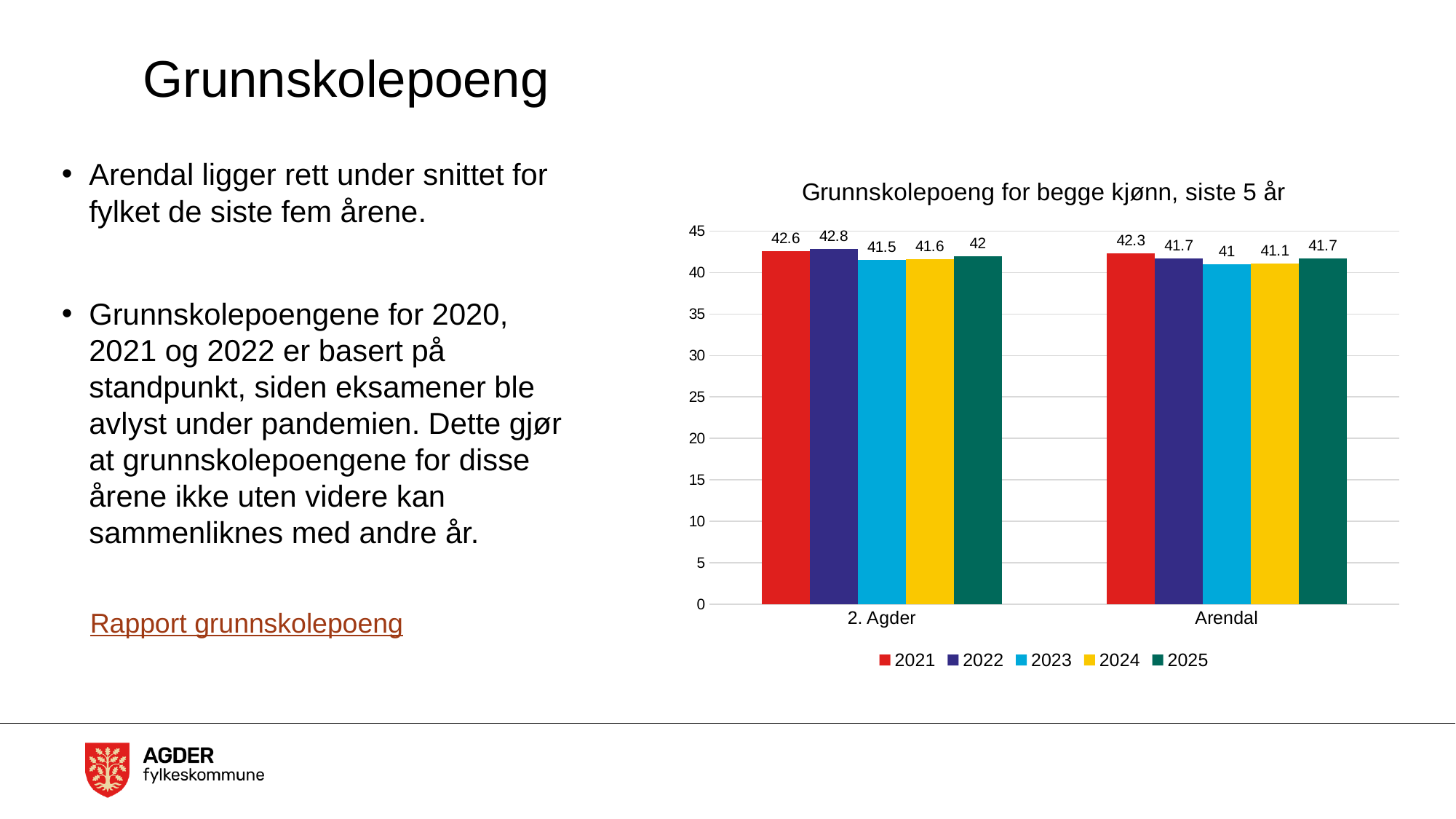
What is the difference between the 2021 values for 2. Agder and Arendal? 0.3 What is the value for Arendal in 2025? 41.7 What is the value for Arendal in 2023? 41 What is the title of the chart? Grunnskolepoeng for begge kjønn, siste 5 år What is the value for 2. Agder in 2022? 42.8 Which year has the lowest value for Arendal? 2023 Which is larger, the 2024 value for 2. Agder or the 2024 value for Arendal? 2. Agder Which year has the highest value for 2. Agder? 2022 How many series does the legend list? 5 What kind of chart is shown on the slide? Bar chart How many categories are shown on the x axis? 2 What is the value for 2. Agder in 2025? 42